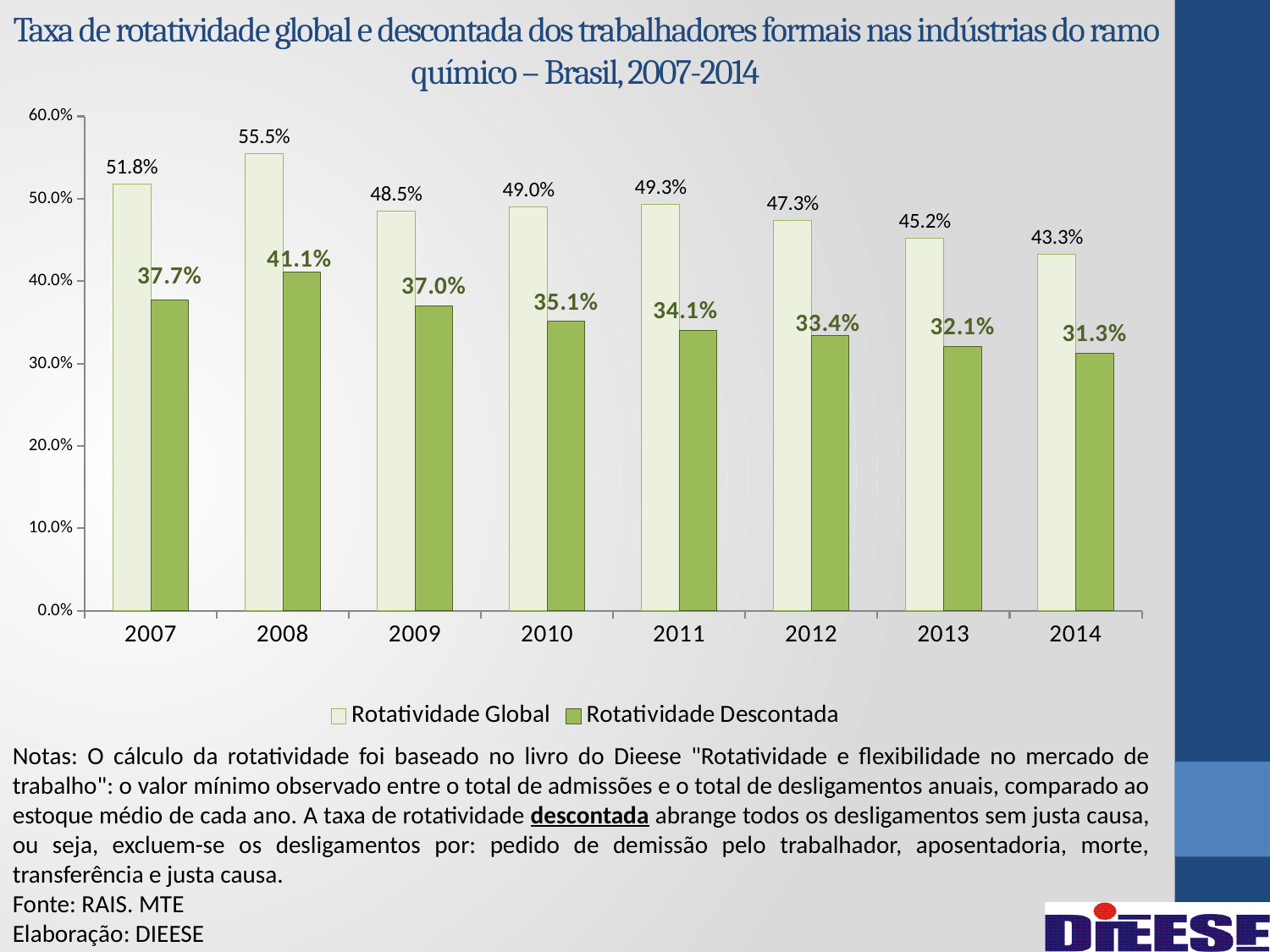
Which year has the highest Rotatividade Global? 2008 Does Rotatividade Descontada rise or fall from 2008 to 2014? fall What is the source cited for the data on the slide? RAIS. MTE Which year has the lowest Rotatividade Descontada? 2014 What is the Rotatividade Descontada value for 2014? 31.3% What is the Rotatividade Global value for 2008? 55.5% How many years are shown on the x axis? 8 Which is larger: Rotatividade Descontada in 2009 or in 2010? 2009 What is the difference between Rotatividade Global and Rotatividade Descontada in 2007? 14.1% Is the Rotatividade Global value for 2014 greater or less than 40.0%? greater What kind of chart is shown on the slide? bar chart How many series does the legend list? 2